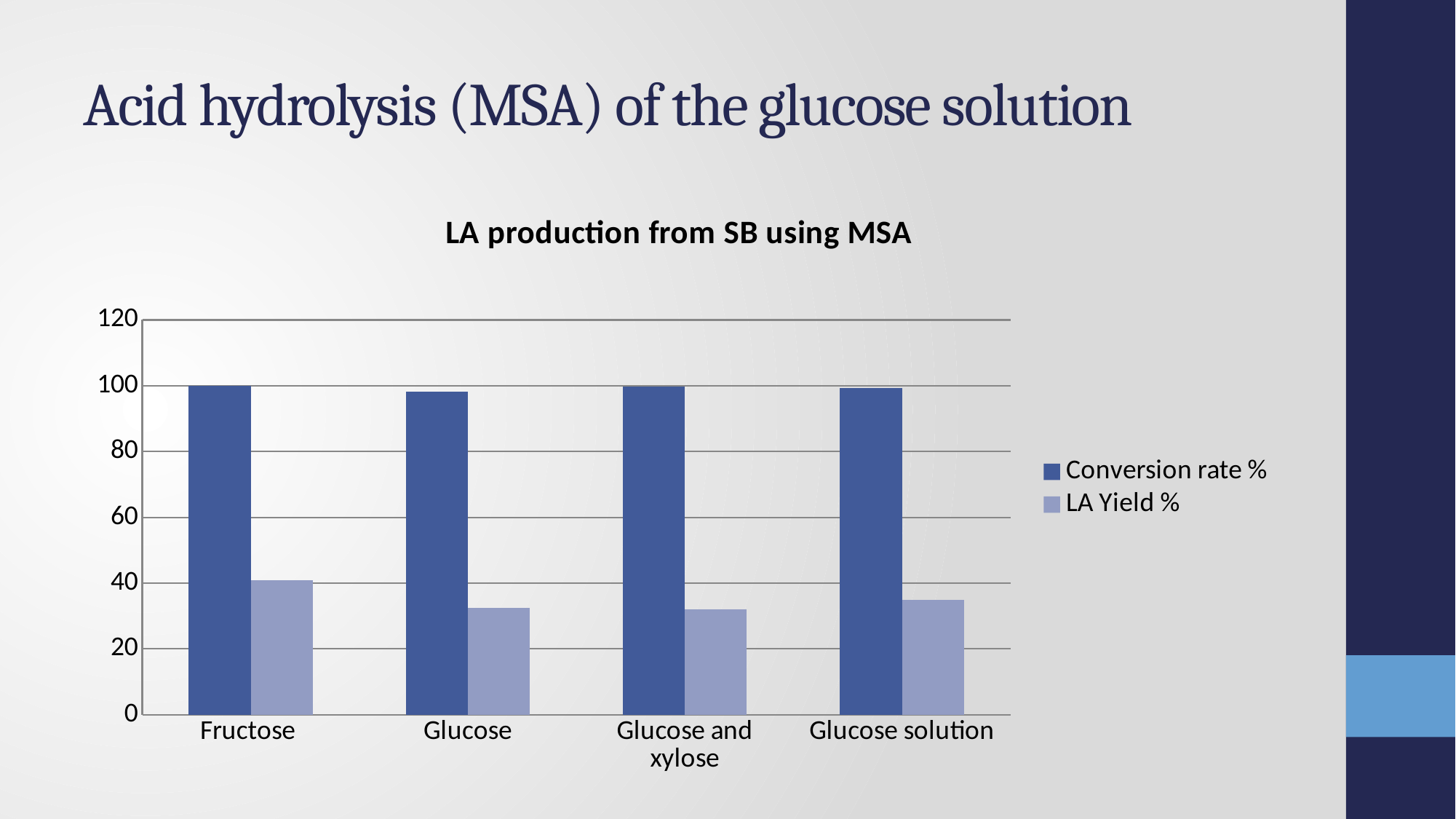
Is the LA Yield % for Fructose greater or less than 60? less Which category has the highest LA Yield %? Fructose What type of chart is shown on the slide? Bar chart Which is larger, the LA Yield % for Fructose or the LA Yield % for Glucose? Fructose Which series is shown in the lighter blue bars? LA Yield % How many series does the legend list? 2 For Glucose solution, which is larger, the Conversion rate % or the LA Yield %? Conversion rate % Is the LA Yield % for Glucose greater or less than 40? less Is the Conversion rate % for Glucose greater or less than 80? greater How many categories are shown on the x axis? 4 What is the title of the chart? LA production from SB using MSA